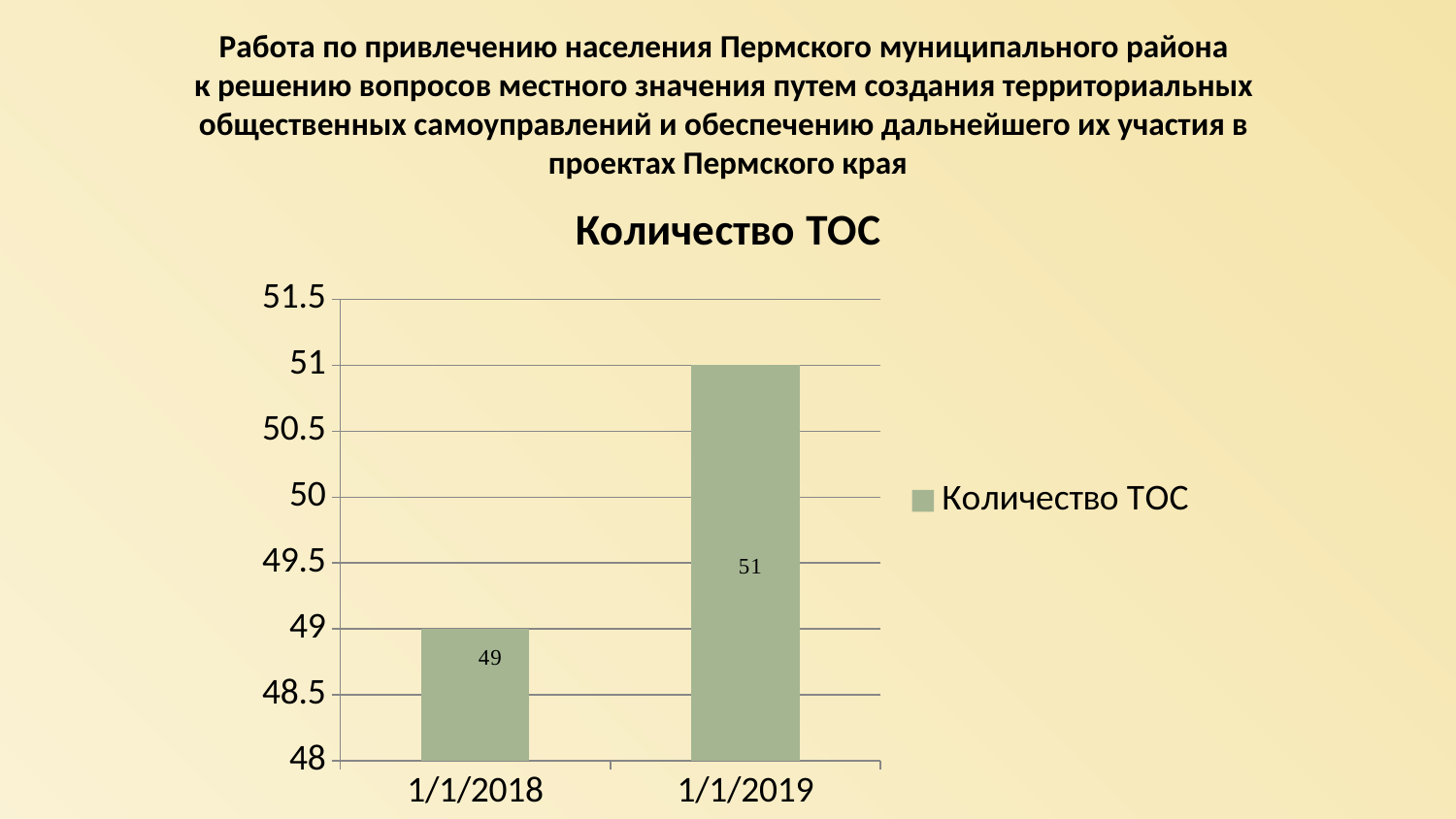
Which is larger, the value for 1/1/2018 or the value for 1/1/2019? 1/1/2019 How many categories are shown on the x axis? 2 Which category has the highest value? 1/1/2019 What is the title of the chart? Количество ТОС Is the value for 1/1/2019 greater or less than 50? greater What is the value for 1/1/2019? 51 Is the value for 1/1/2018 greater or less than 50? less What is the difference between the values for 1/1/2019 and 1/1/2018? 2 What is the value for 1/1/2018? 49 What kind of chart is shown? bar chart How many series does the legend list? 1 Which category has the lowest value? 1/1/2018